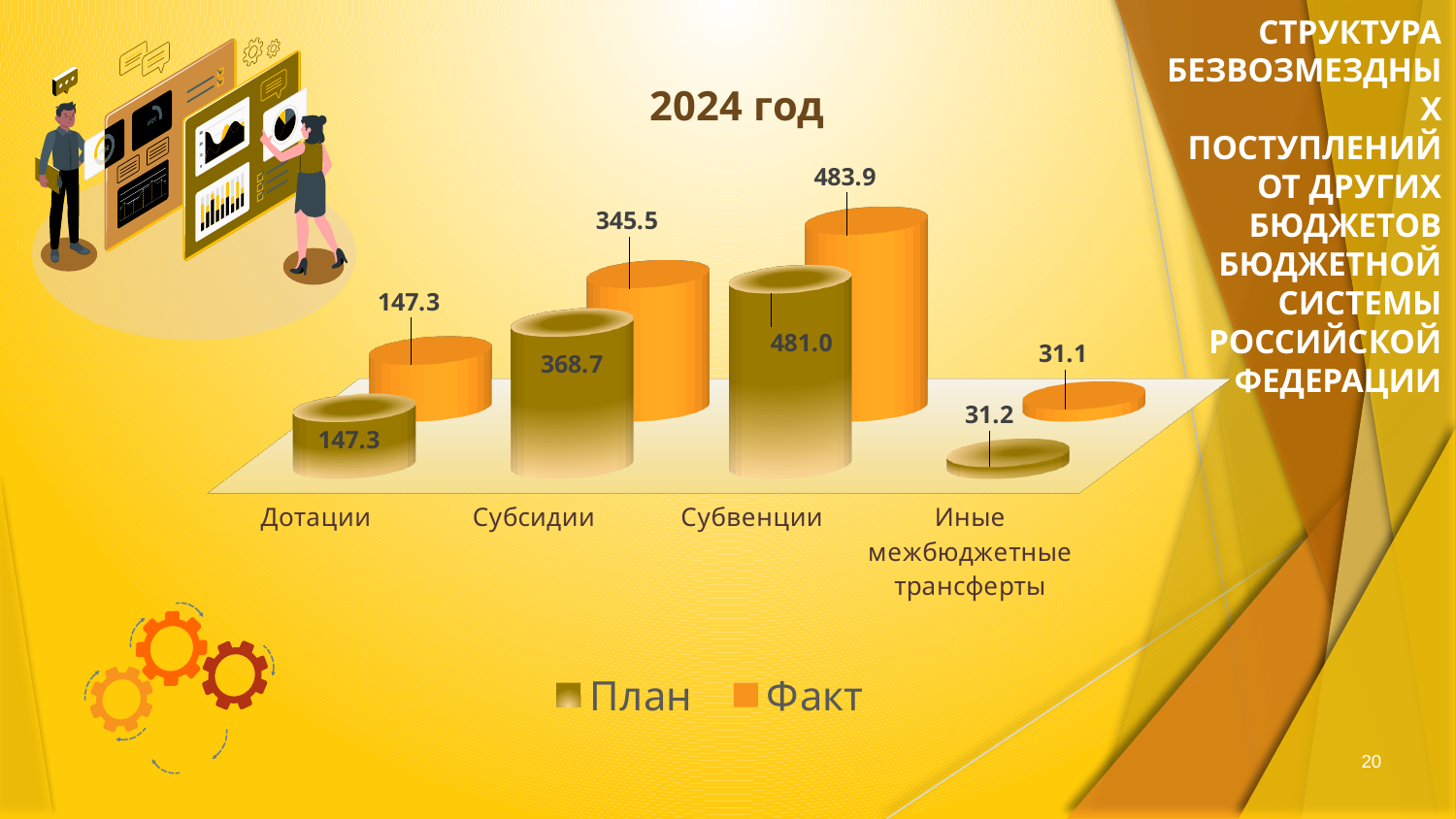
How many series does the legend list? 2 What is the difference between the План and Факт values for Субсидии? 23.2 What is the difference between the Факт and План values for Субвенции? 2.9 Which category has the lowest План value? Иные межбюджетные трансферты How many categories are shown on the x axis? 4 What is the План value for Субсидии? 368.7 What is the title of the chart? 2024 год What is the План value for Дотации? 147.3 Which category has the highest Факт value? Субвенции What is the Факт value for Иные межбюджетные трансферты? 31.1 What is the Факт value for Субвенции? 483.9 For Субсидии, which is larger: План or Факт? План